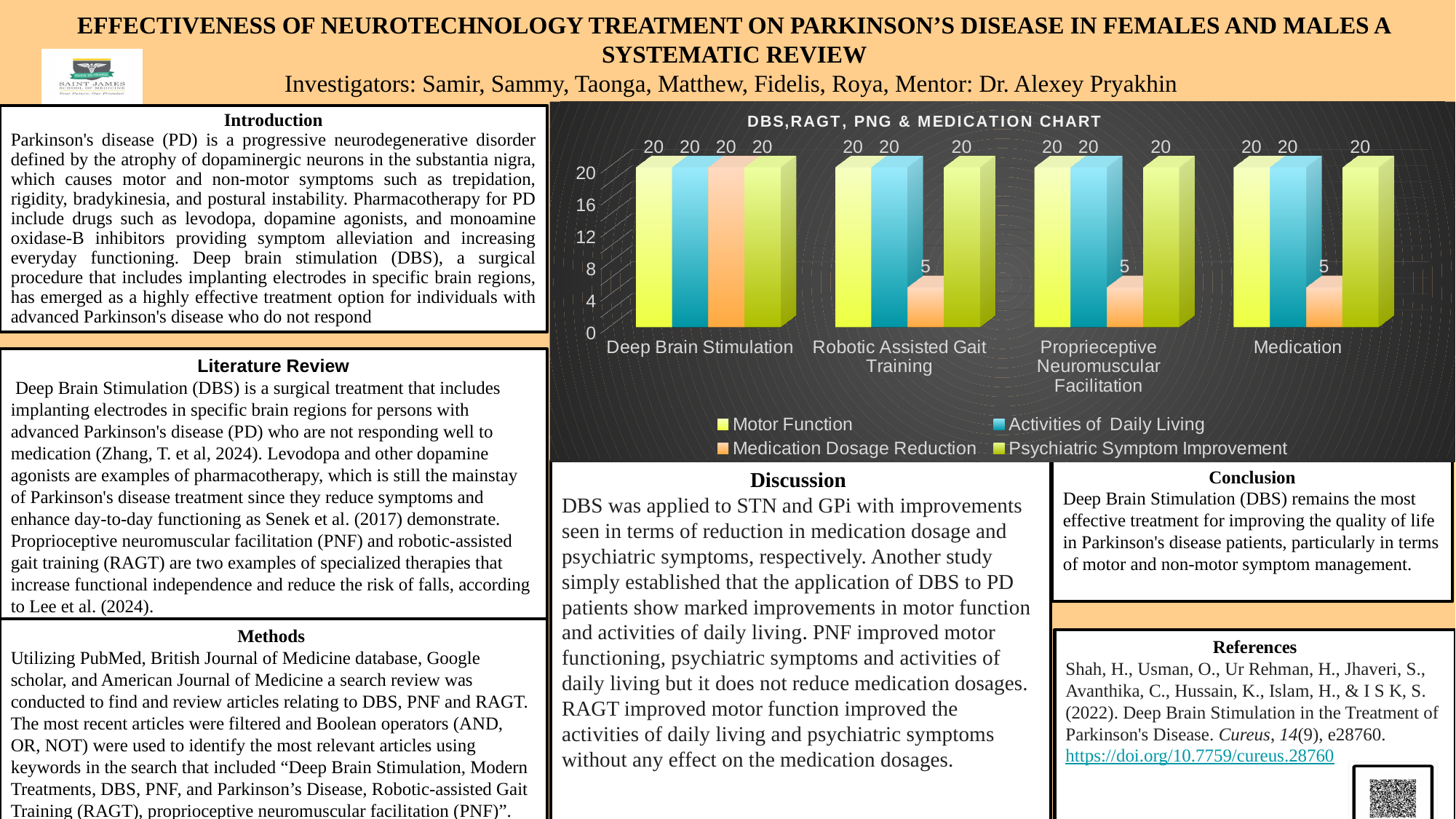
How many treatment categories are shown on the x axis of the chart? 4 Which is larger: the Medication Dosage Reduction value for Deep Brain Stimulation or for Medication? Deep Brain Stimulation Is the Medication Dosage Reduction value for Medication greater or less than 12? less Which category has the highest Medication Dosage Reduction value? Deep Brain Stimulation What type of chart is shown on the slide? bar chart What is the Motor Function value for Medication? 20 Which series is shown in orange in the chart legend? Medication Dosage Reduction What is the Medication Dosage Reduction value for Deep Brain Stimulation? 20 What is the Medication Dosage Reduction value for Robotic Assisted Gait Training? 5 How many series does the chart legend list? 4 What is the title of the chart? DBS,RAGT, PNG & MEDICATION CHART What is the difference between the Medication Dosage Reduction values for Deep Brain Stimulation and Proprieceptive Neuromuscular Facilitation? 15